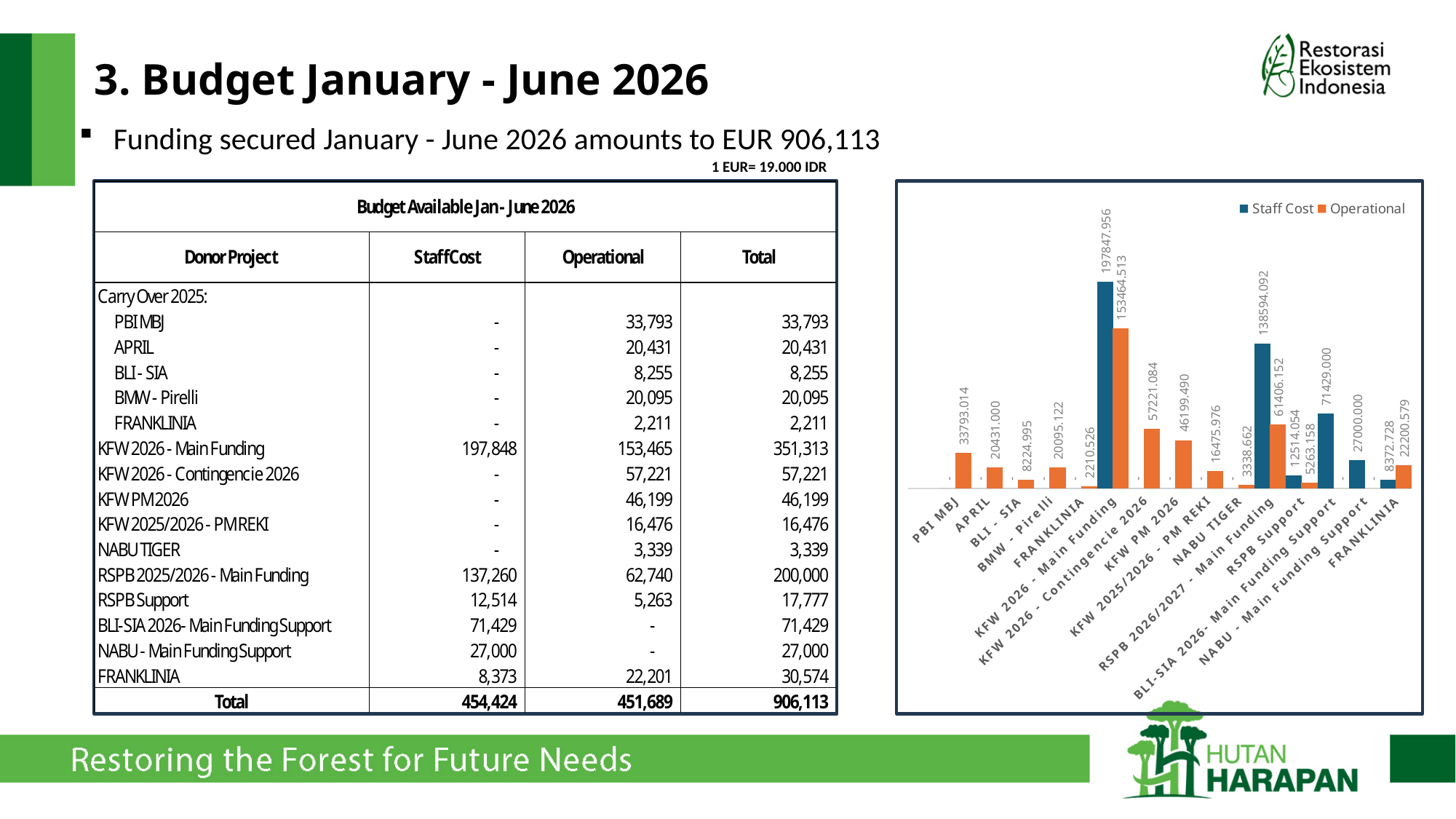
Which category has the highest Staff Cost in the chart? KFW 2026 - Main Funding What is the difference between the Staff Cost and Operational values for RSPB 2026/2027 - Main Funding in the chart? 77187.940 What is the Staff Cost value for BLI-SIA 2026 - Main Funding Support in the chart? 71429.000 What is the Operational value for KFW 2026 - Main Funding in the chart? 153464.513 What is the Operational value for PBI MBJ in the chart? 33793.014 What is the Staff Cost value for KFW 2026 - Main Funding in the chart? 197847.956 Which is larger in the chart: the Operational value for KFW 2026 - Contingencie 2026 or for KFW PM 2026? KFW 2026 - Contingencie 2026 What is the Operational value for NABU TIGER in the chart? 3338.662 Which colour represents the Operational series in the chart? Orange What kind of chart is shown on the slide? Bar chart Which category has the highest Operational value in the chart? KFW 2026 - Main Funding How many series does the chart legend list? 2